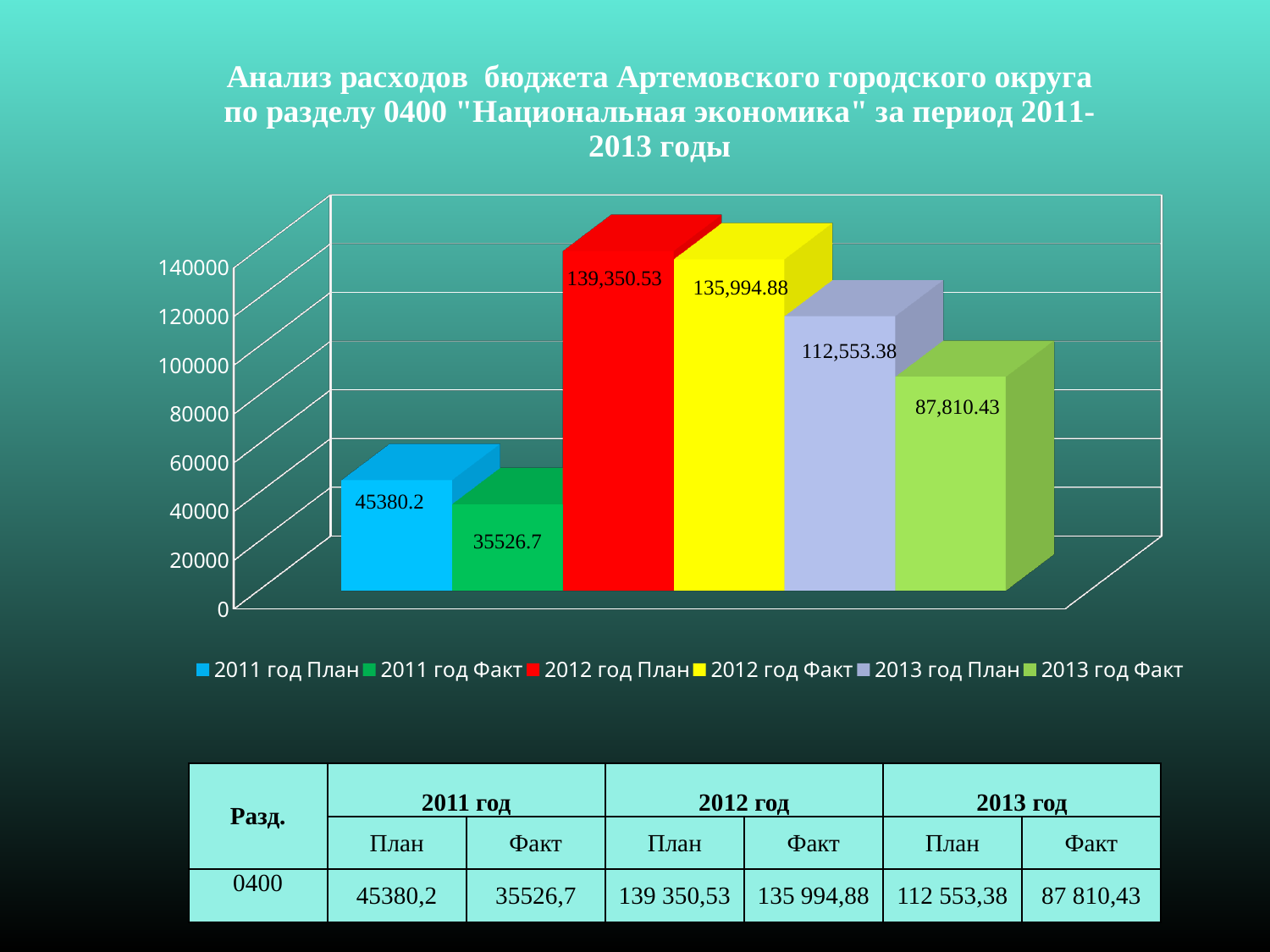
Is the value for 2013 год Факт greater or less than 100000? less Which series has the lowest value on the chart? 2011 год Факт What is the value shown for 2013 год Факт? 87,810.43 What is the value shown for 2011 год План? 45380.2 What kind of chart is shown on the slide? bar chart What is the value shown for 2012 год Факт? 135,994.88 What is the difference between 2012 год План and 2012 год Факт? 3,355.65 How many series does the legend list? 6 Which series has the highest value on the chart? 2012 год План What is the value shown for 2013 год План? 112,553.38 Which is larger, 2013 год План or 2013 год Факт? 2013 год План What is the difference between 2011 год План and 2011 год Факт? 9853.5